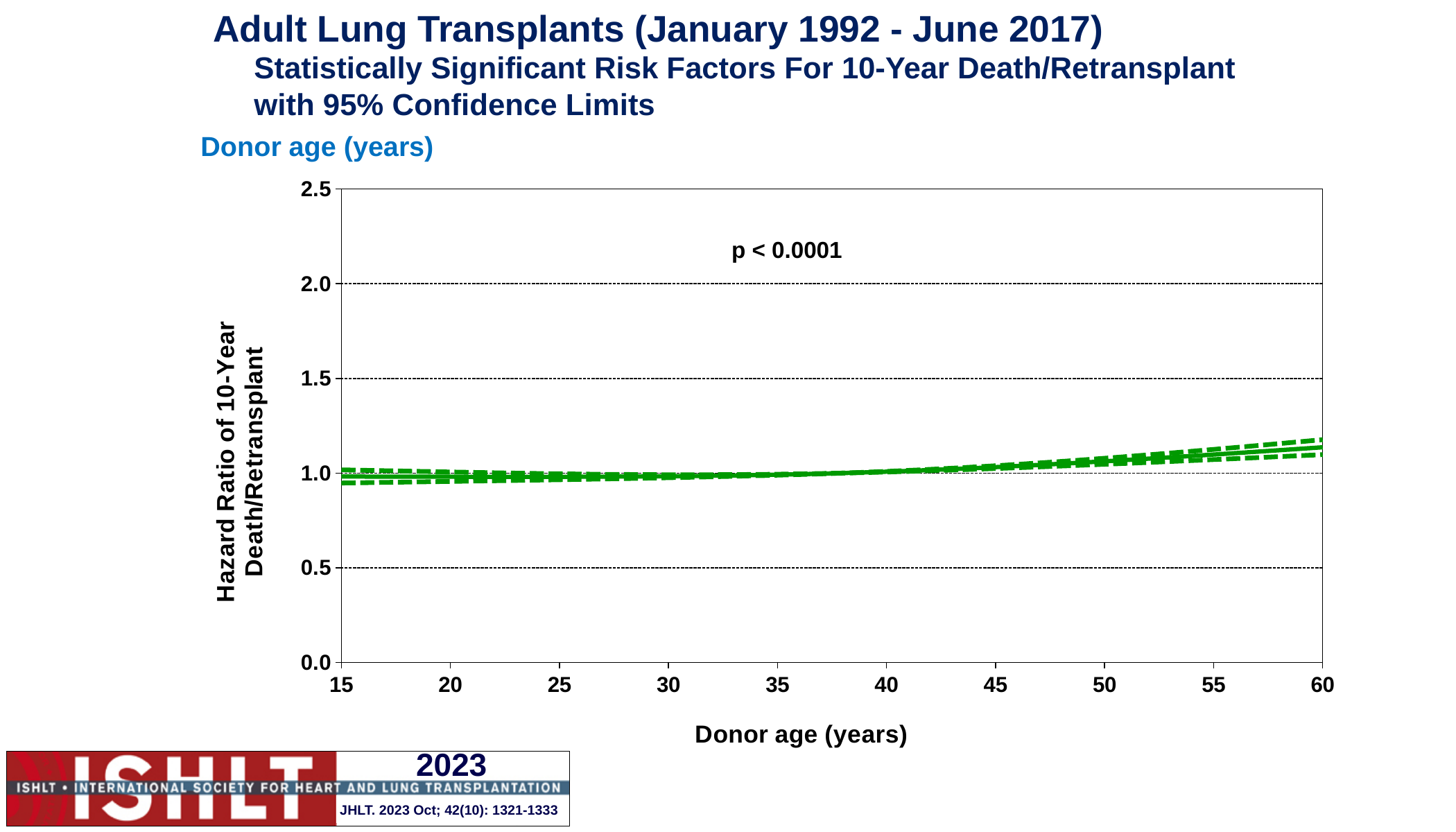
At which donor age shown on the x axis is the hazard ratio highest? 60 Is the hazard ratio at donor age 40 greater or less than 0.5? greater Is the hazard ratio at donor age 20 greater or less than 1.5? less What p-value is printed on the chart? p < 0.0001 Which has the larger hazard ratio: donor age 30 or donor age 60? donor age 60 What is the label of the y axis? Hazard Ratio of 10-Year Death/Retransplant Is the hazard ratio at donor age 60 greater or less than 1.0? greater Does the hazard ratio rise or fall as donor age increases from 15 to 60 years? rise What kind of chart is shown on the slide? line chart